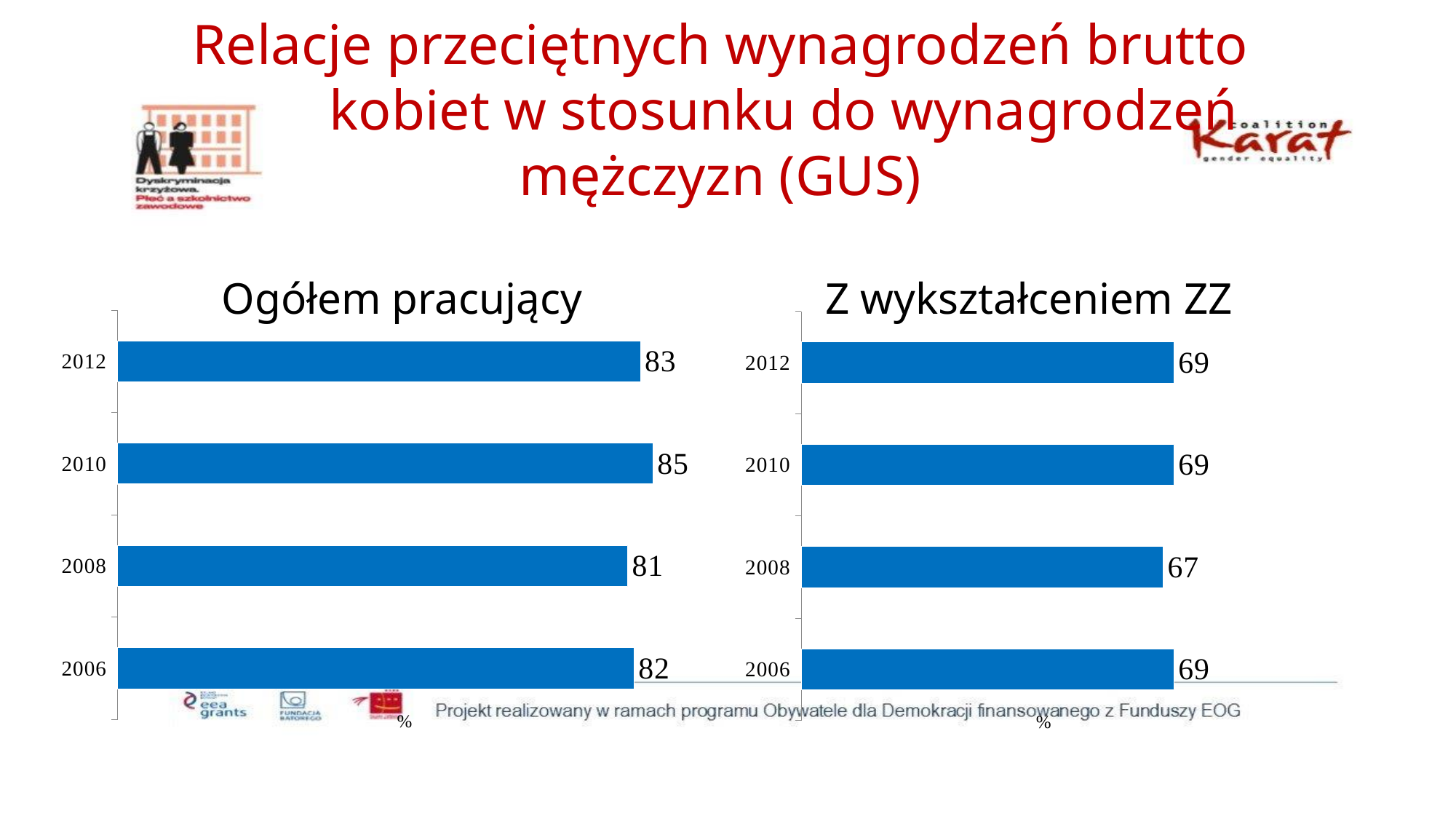
What kind of chart is the 'Ogółem pracujący' chart? Bar chart In the 'Ogółem pracujący' chart, what is the value for 2012? 83 In the 'Z wykształceniem ZZ' chart, what is the value for 2008? 67 In the 'Ogółem pracujący' chart, which year has the highest value? 2010 In the 'Z wykształceniem ZZ' chart, what is the difference between the values for 2012 and 2008? 2 In the 'Z wykształceniem ZZ' chart, which year has the lowest value? 2008 In the 'Ogółem pracujący' chart, what is the value for 2008? 81 In the 'Z wykształceniem ZZ' chart, what is the value for 2006? 69 In the 'Ogółem pracujący' chart, which year has the lowest value? 2008 How many years are shown in the 'Z wykształceniem ZZ' chart? 4 In the 'Ogółem pracujący' chart, what is the difference between the values for 2010 and 2008? 4 Which is larger: the 2012 value in the 'Ogółem pracujący' chart or the 2012 value in the 'Z wykształceniem ZZ' chart? Ogółem pracujący